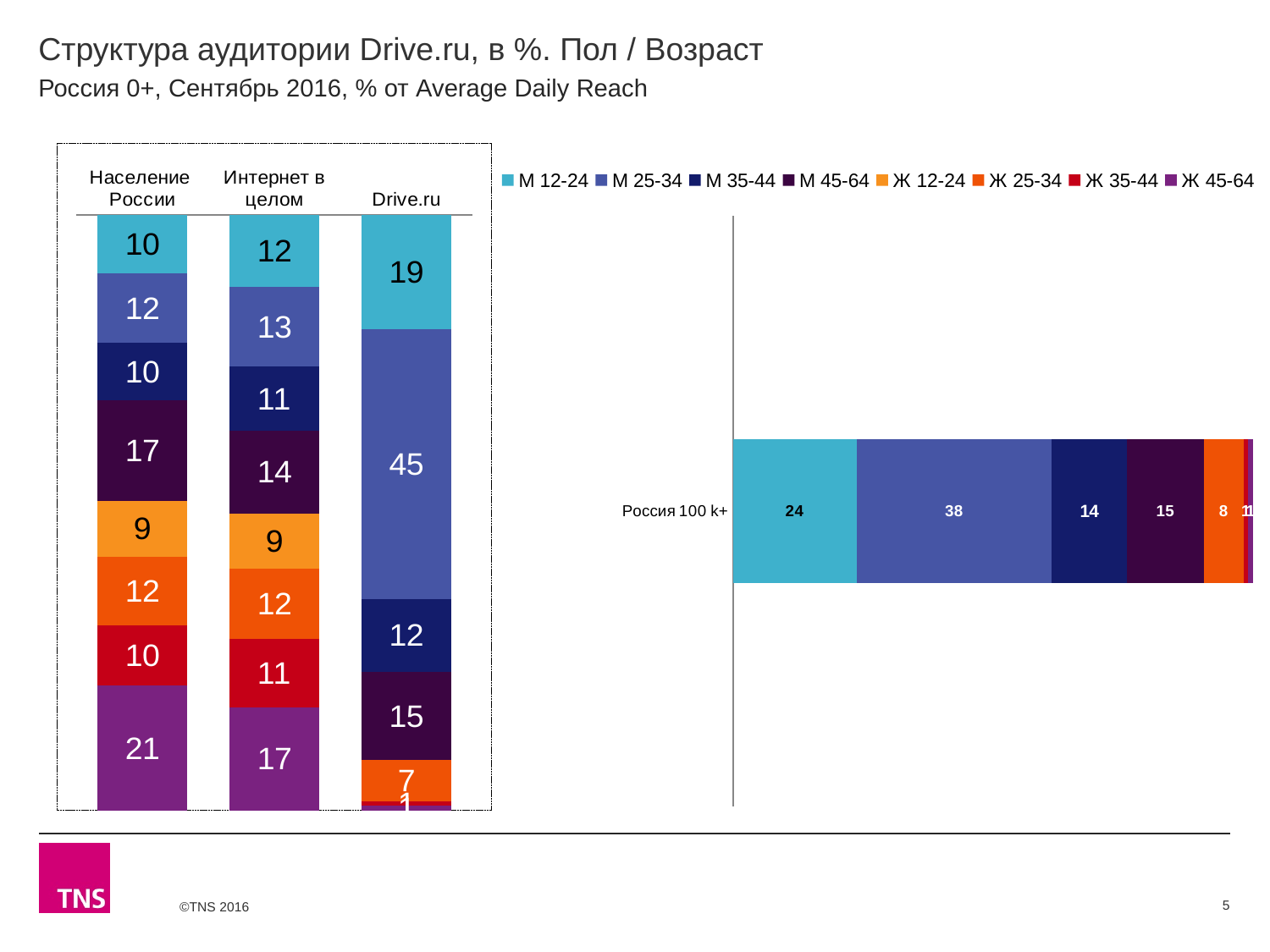
What kind of chart is the right chart labelled Россия 100 k+? Stacked bar chart In the left chart, which segment of the Drive.ru bar is the largest? M 25-34 How many series does the legend list? 8 In the left chart, what is the value of the largest segment (M 25-34) in the Drive.ru bar? 45 In the left chart, what is the value of the bottom (Ж 45-64) segment of the Население России bar? 21 In the left chart, what is the value of the top (M 12-24) segment of the Drive.ru bar? 19 In the left chart, what is the value of the M 45-64 segment in the Интернет в целом bar? 14 In the left chart, what is the difference between the M 25-34 segment of Drive.ru (45) and the M 25-34 segment of Интернет в целом (13)? 32 In the right chart (Россия 100 k+), what is the difference between the M 12-24 segment (24) and the M 35-44 segment (14)? 10 How many bars does the left chart show? 3 In the right chart (Россия 100 k+), what is the value of the M 25-34 segment? 38 In the left chart, which is larger: the Ж 45-64 segment for Население России or for Интернет в целом? Население России